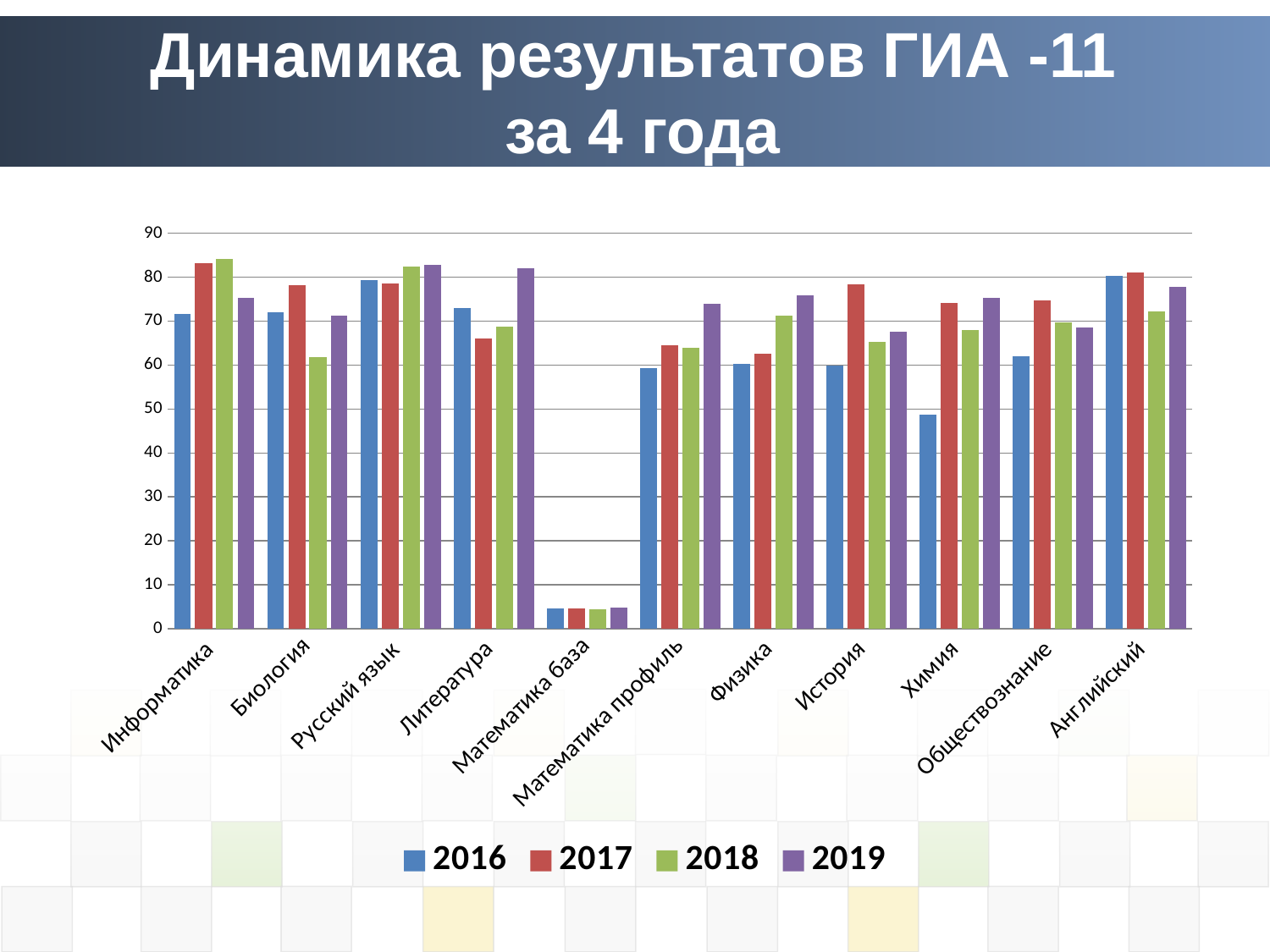
What kind of chart is shown on the slide? bar chart Which is larger for Химия: the 2016 value or the 2017 value? 2017 How many series does the legend list? 4 Is the 2019 value for Физика greater or less than 70? greater Which subject has the lowest values across all four years? Математика база Is the 2017 value for Информатика greater or less than 80? greater Is the 2019 value for Литература greater or less than 80? greater Which is larger for Литература: the 2017 value or the 2019 value? 2019 What is the title of the slide? Динамика результатов ГИА -11 за 4 года Which is larger for Биология: the 2017 value or the 2018 value? 2017 How many subject categories are shown on the x axis? 11